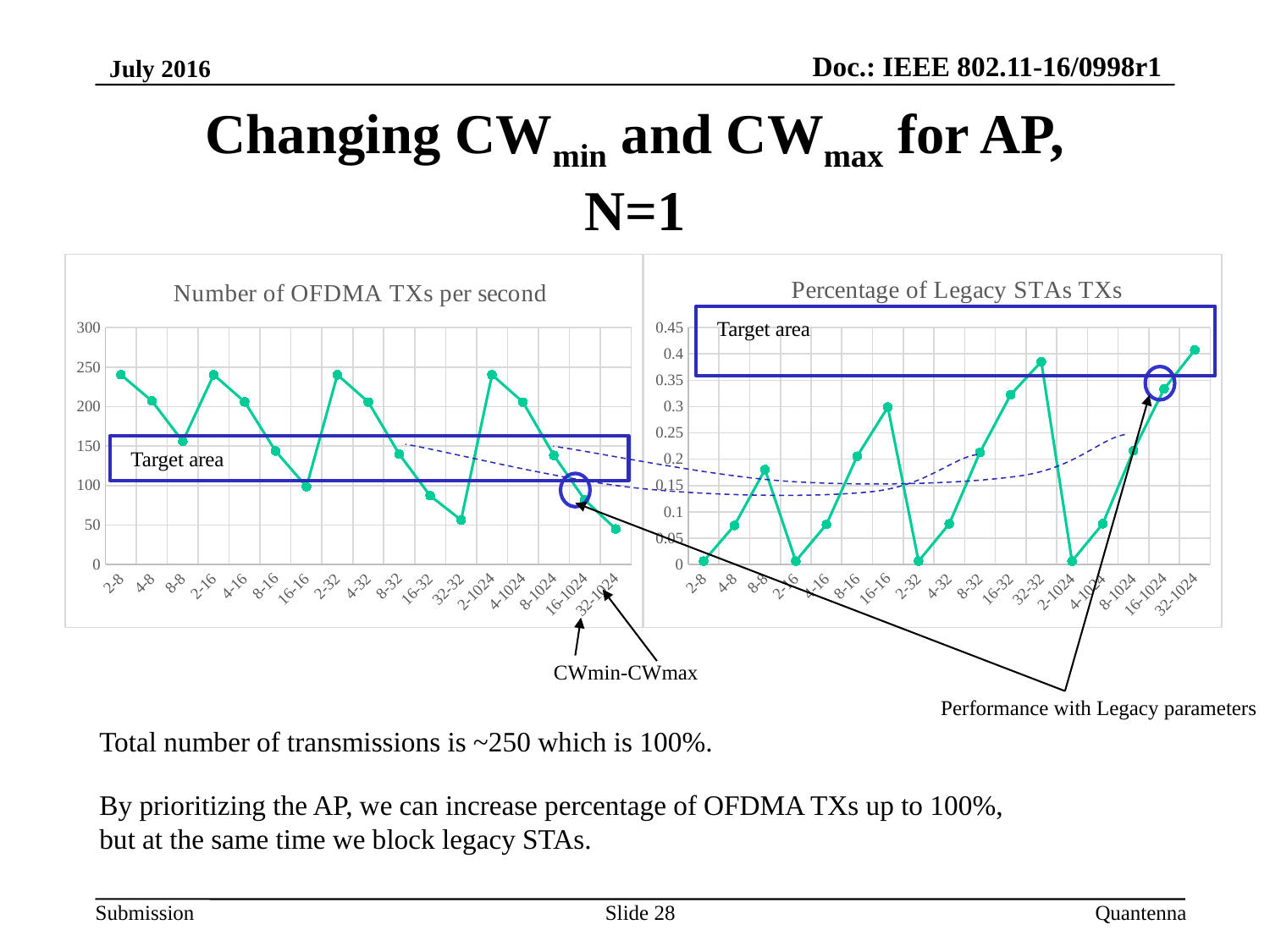
How many categories are plotted on the x axis of the "Percentage of Legacy STAs TXs" chart? 17 In the "Number of OFDMA TXs per second" chart, is the value for 2-8 greater or less than 200? greater In the "Percentage of Legacy STAs TXs" chart, do the values rise or fall from 2-1024 to 32-1024? rise In the "Percentage of Legacy STAs TXs" chart, is the value for 16-16 greater or less than 0.25? greater In the "Percentage of Legacy STAs TXs" chart, which is larger, the value for 32-32 or the value for 2-1024? 32-32 In the "Percentage of Legacy STAs TXs" chart, which category has the highest value? 32-1024 What is the title of the chart on the left side of the slide? Number of OFDMA TXs per second In the "Number of OFDMA TXs per second" chart, which is larger, the value for 2-8 or the value for 8-8? 2-8 In the "Percentage of Legacy STAs TXs" chart, is the value for 4-32 greater or less than 0.1? less In the "Number of OFDMA TXs per second" chart, which is larger, the value for 16-16 or the value for 2-32? 2-32 What kind of chart is the "Number of OFDMA TXs per second" chart? line chart